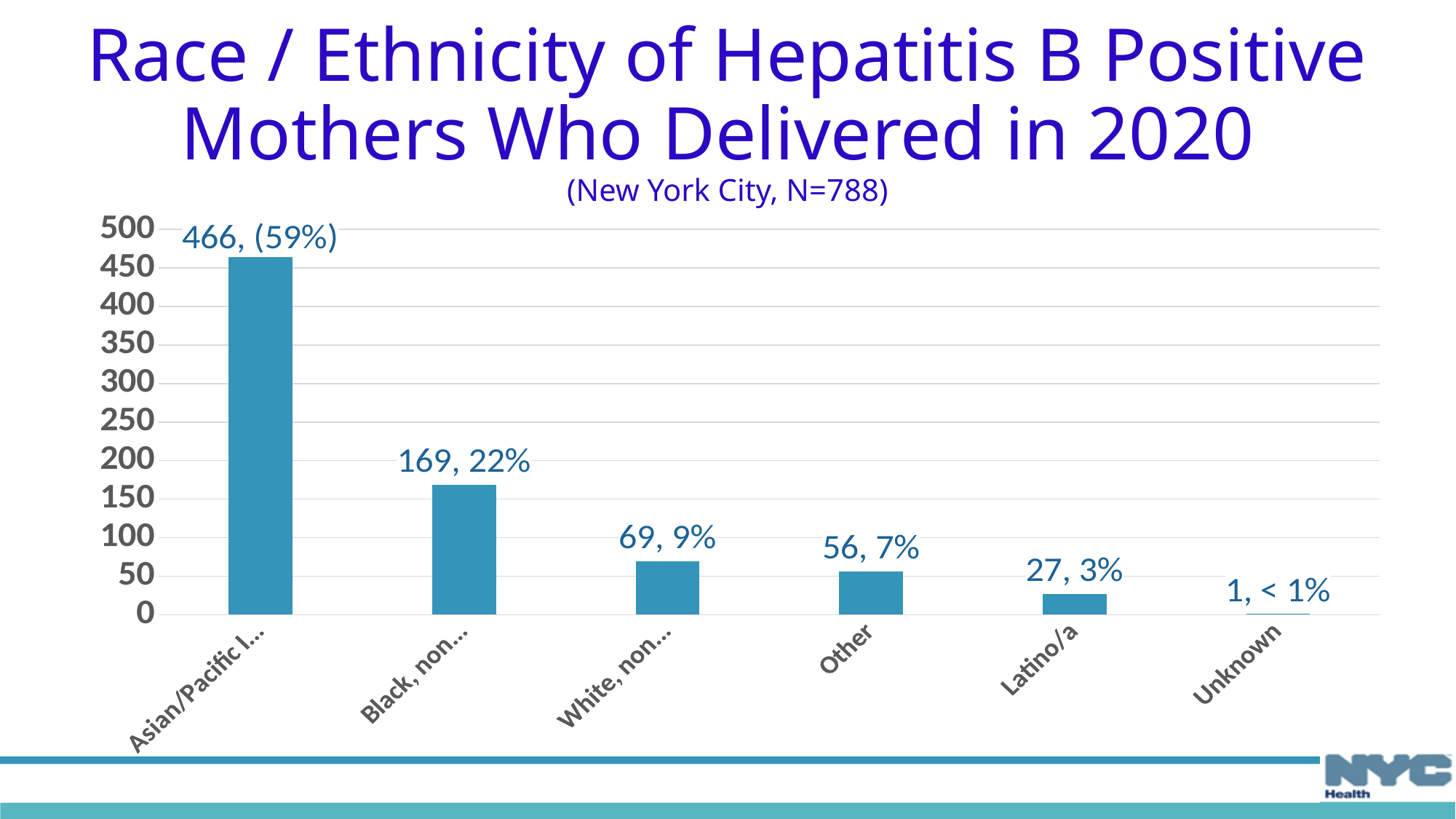
What is the difference between the values for "Other" and Latino/a? 29 Which category has the highest value? Asian/Pacific I… What value is shown for the Unknown category? 1 Which is larger, the value for "Other" or the value for Latino/a? Other What is the number of Hepatitis B positive mothers in the "Other" category? 56 What percentage is shown for the "Other" category? 7% What value is shown for the Latino/a category? 27 What is the difference between the first bar (466) and the second bar (169)? 297 Which category has the lowest value? Unknown How many race/ethnicity categories are shown on the chart? 6 What kind of chart is shown on the slide? Bar chart What value is shown for the second bar from the left (labelled "Black, non…")? 169